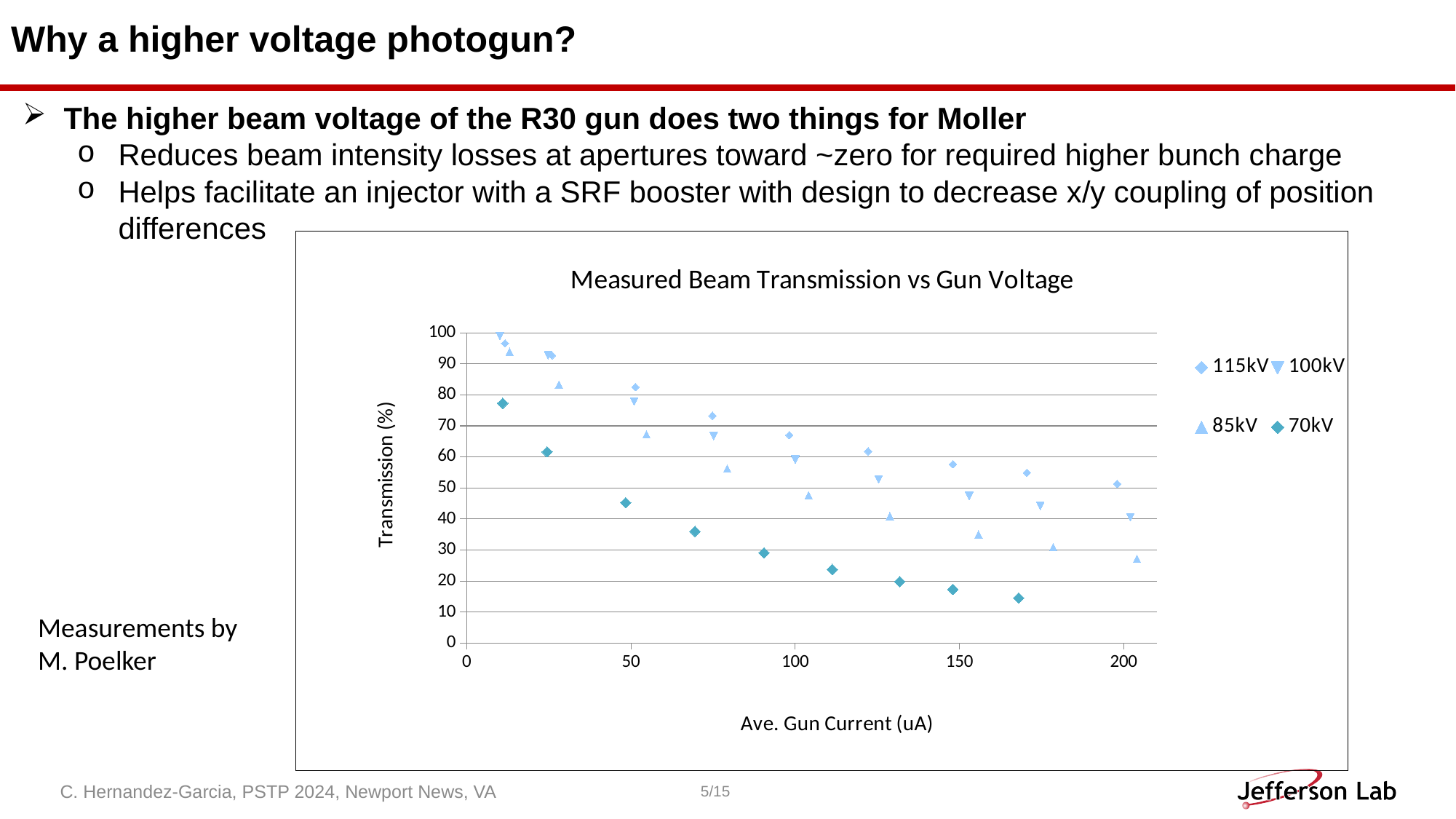
Which series has the highest transmission at around 200 uA? 115kV What is the title of the chart? Measured Beam Transmission vs Gun Voltage As average gun current increases, does transmission rise or fall for each series? fall Is the transmission for the 70kV series at about 10 uA greater or less than 70? greater Is the transmission for the 70kV series at about 170 uA greater or less than 20? less What kind of chart is shown on the slide? scatter chart Is the transmission for the 70kV series at about 110 uA greater or less than 30? less At around 100 uA, which series has the higher transmission, 115kV or 70kV? 115kV Which series has the lowest transmission values across the chart? 70kV How many series does the legend of the chart list? 4 What is the label of the x axis of the chart? Ave. Gun Current (uA)